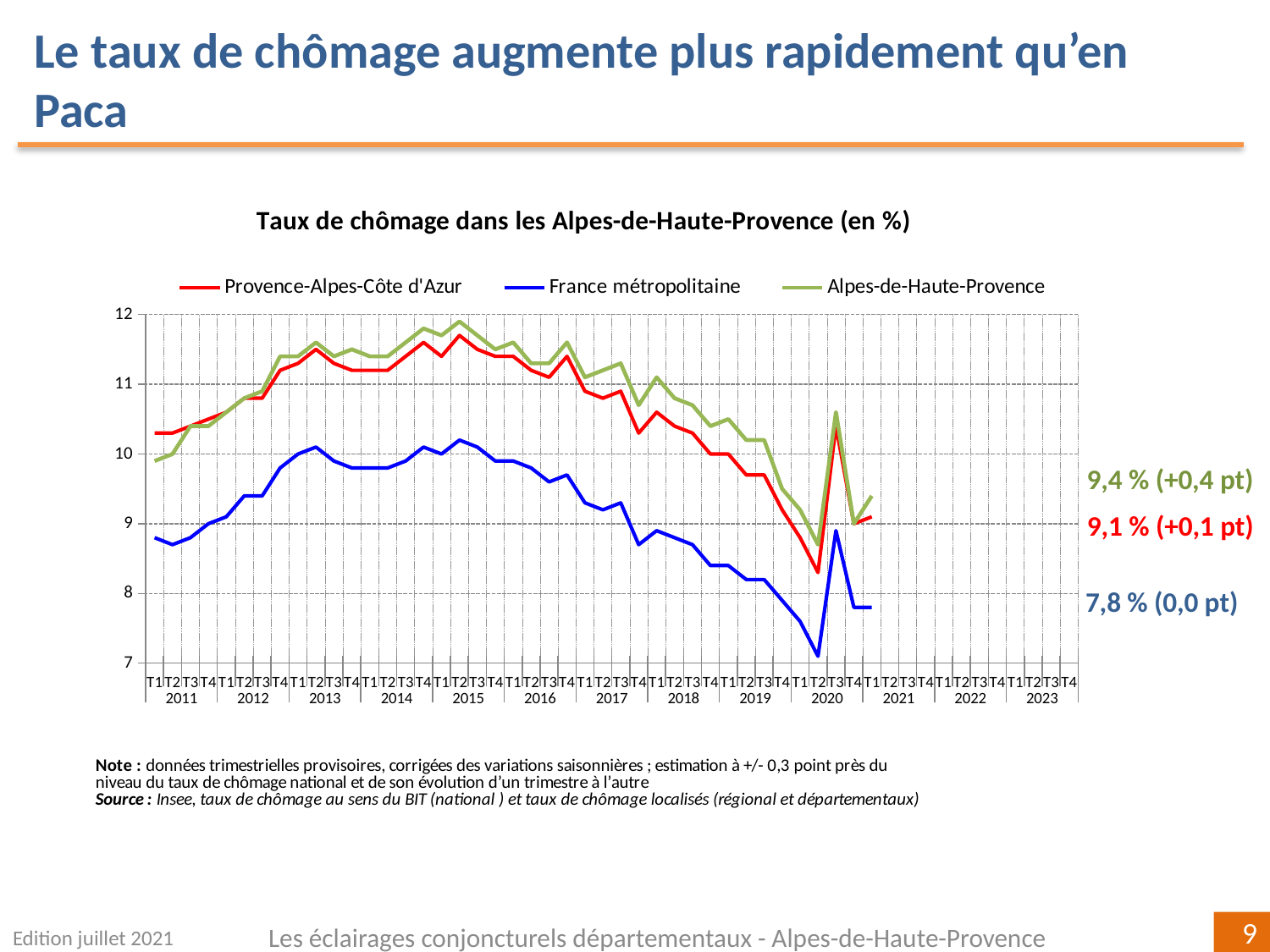
Between 2015 and 2019, do the unemployment rates generally rise or fall? fall What kind of chart is shown? line chart Is the value for France métropolitaine in T1 2011 greater or less than 9? less What is the difference between the latest values for Alpes-de-Haute-Provence and France métropolitaine? 1,6 points Is the latest value for Provence-Alpes-Côte d'Azur larger or smaller than the latest value for Alpes-de-Haute-Provence? smaller What is the latest unemployment rate shown for Provence-Alpes-Côte d'Azur? 9,1 % How many series does the legend list? 3 What is the latest unemployment rate shown for Alpes-de-Haute-Provence? 9,4 % Which series has the highest latest value? Alpes-de-Haute-Provence What is the latest unemployment rate shown for France métropolitaine? 7,8 % What quarterly change is annotated for the Alpes-de-Haute-Provence series? +0,4 pt Which series has the lowest latest value? France métropolitaine